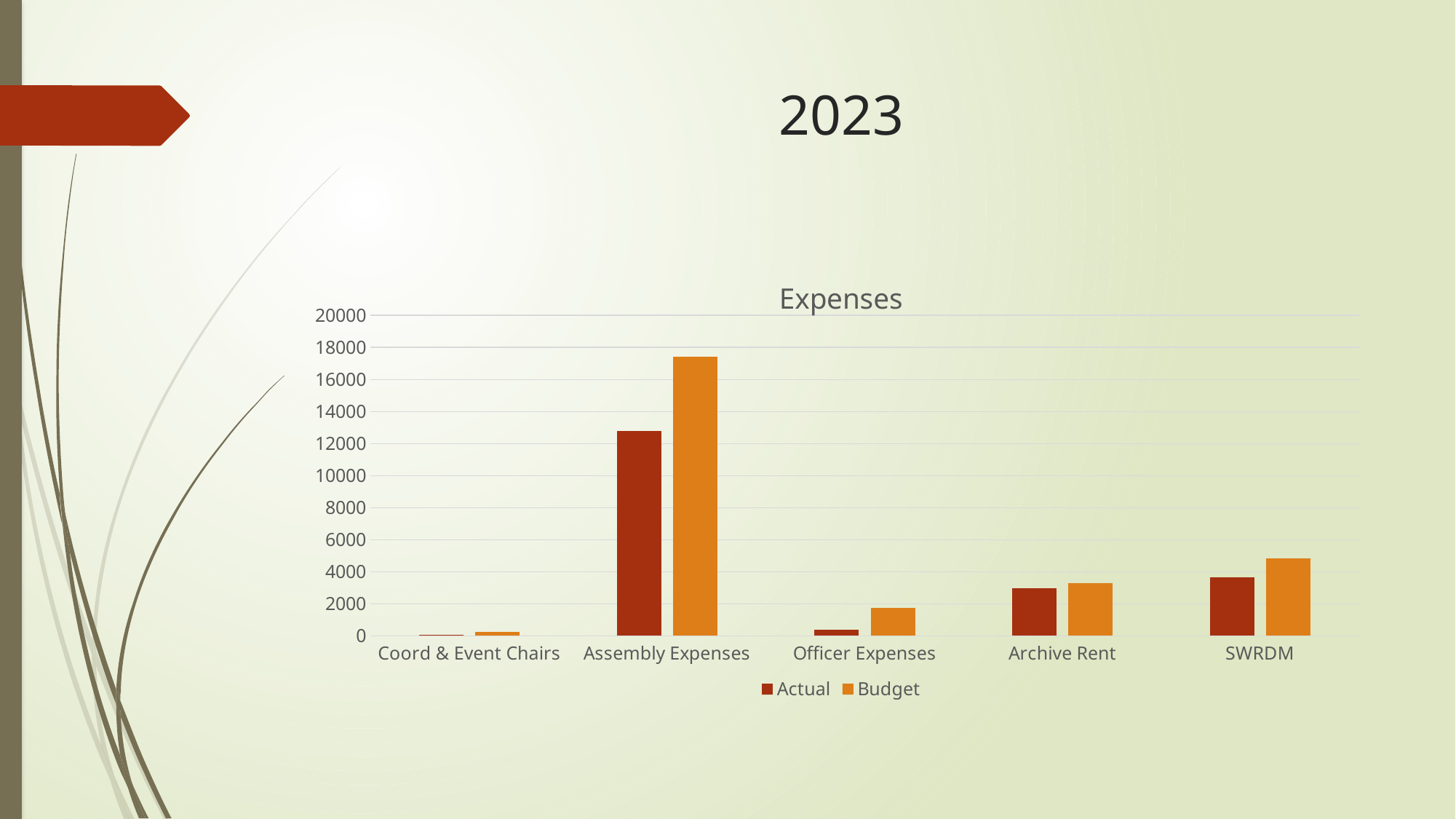
Is the Budget value for Officer Expenses greater or less than 2000? less How many series does the legend list? 2 What are the two series named in the legend? Actual and Budget What is the title of the chart? Expenses For Assembly Expenses, which is larger, Actual or Budget? Budget Which category has the lowest Actual value? Coord & Event Chairs Which category has the highest Budget value? Assembly Expenses What kind of chart is shown on the slide? bar chart Is the Actual value for Assembly Expenses greater or less than 14000? less Is the Budget value for Assembly Expenses greater or less than 16000? greater How many expense categories are shown on the x axis? 5